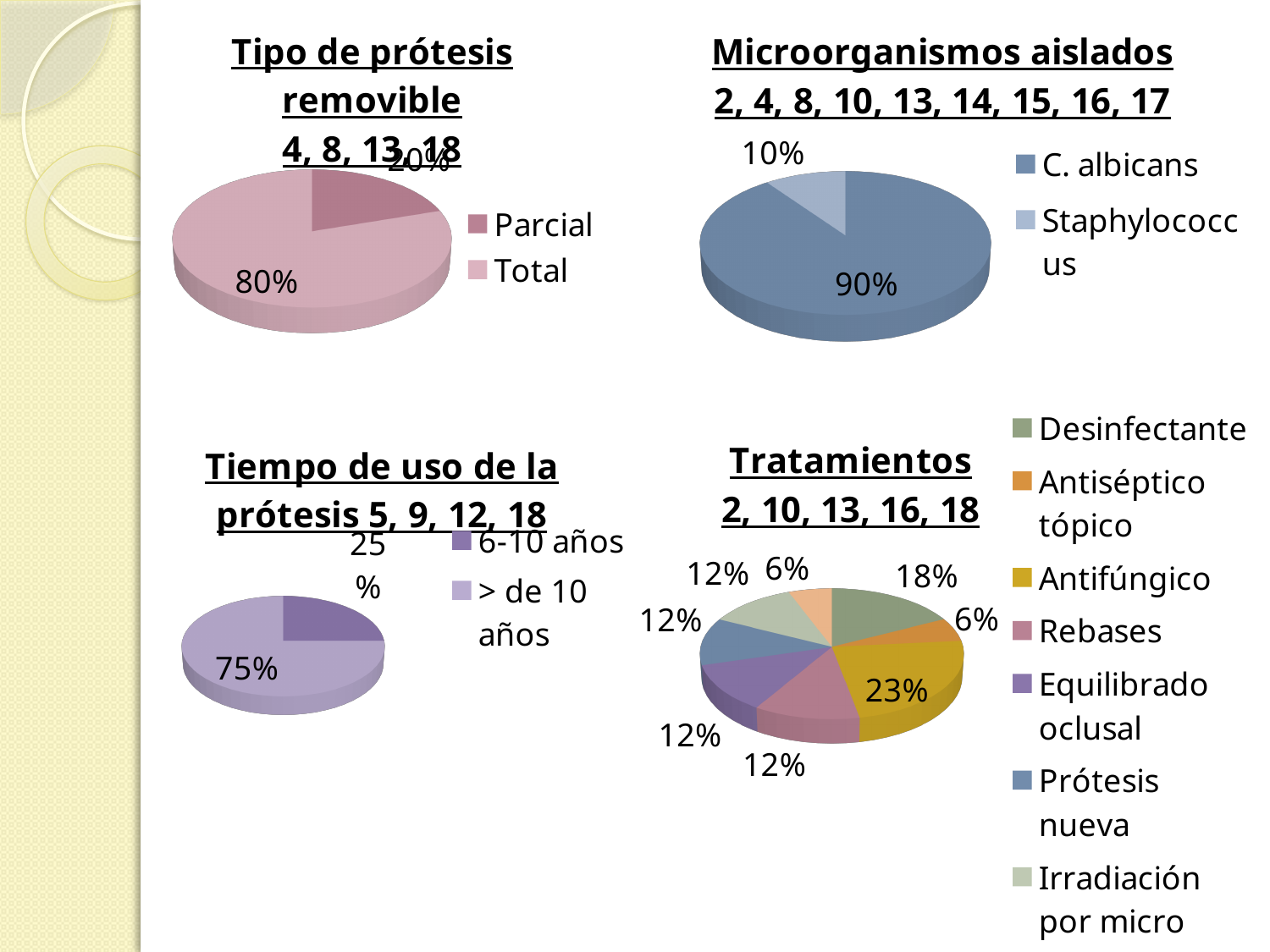
In the 'Microorganismos aislados' chart, which microorganism has the smallest slice? Staphylococcus In the 'Tipo de prótesis removible' chart, what percentage is labelled for Total? 80% In the 'Tiempo de uso de la prótesis' chart, what is the difference between the '> de 10 años' and '6-10 años' slices? 50% In the 'Tratamientos' chart, which is larger, Desinfectante or Antiséptico tópico? Desinfectante What type of chart is the 'Microorganismos aislados' chart? Pie chart In the 'Tratamientos' chart, what percentage is labelled for Desinfectante? 18% In the 'Tratamientos' chart, what percentage is labelled for Antifúngico? 23% In the 'Tiempo de uso de la prótesis' chart, what percentage is labelled for '> de 10 años'? 75% How many entries does the legend of the 'Tratamientos' chart list? 7 In the 'Tratamientos' chart, which treatment has the largest slice? Antifúngico In the 'Microorganismos aislados' chart, what percentage is labelled for C. albicans? 90% In the 'Tipo de prótesis removible' chart, what percentage is labelled for Parcial? 20%